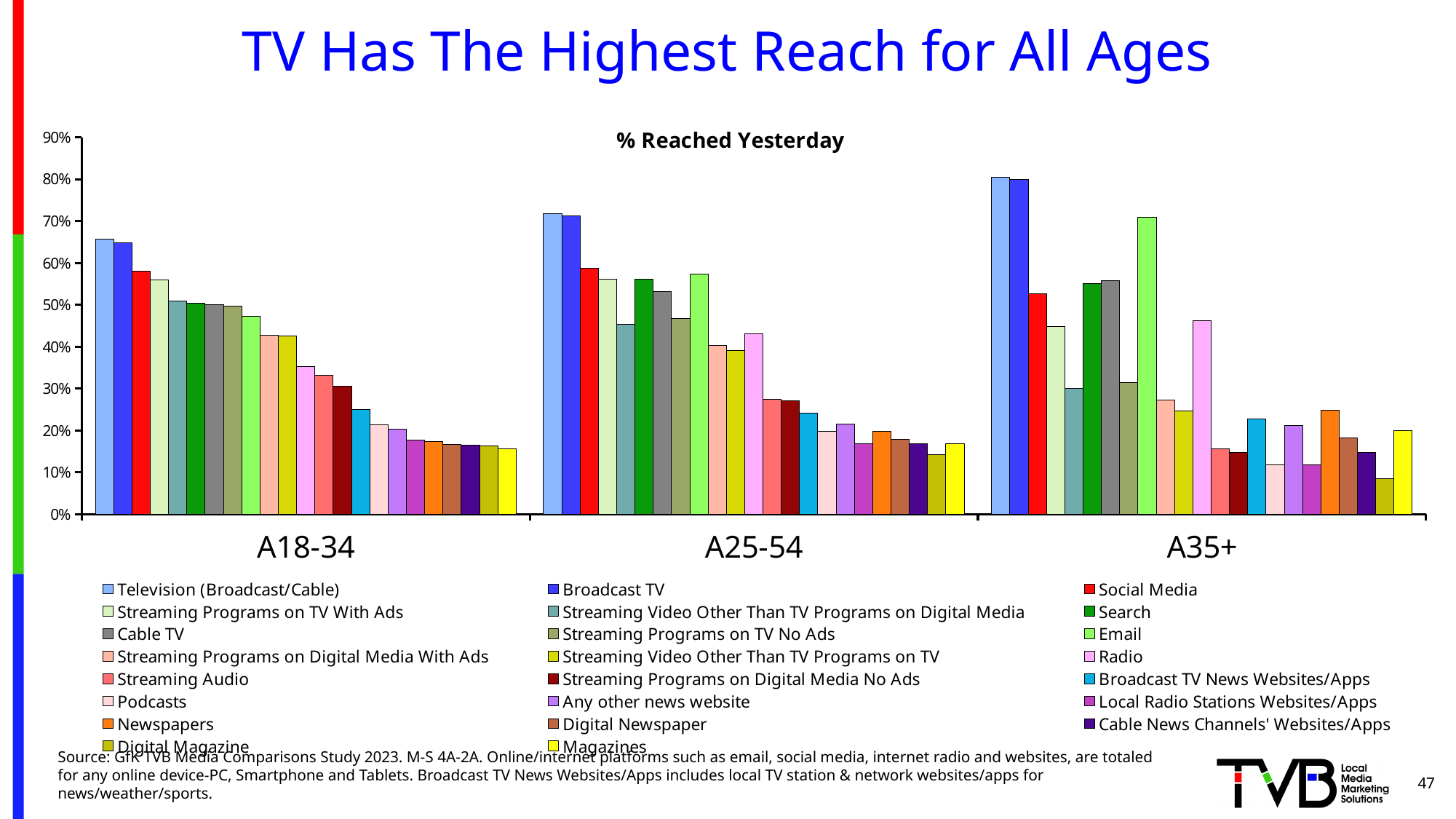
Is the value for Email in the A35+ group greater or less than 60%? greater Does the Email value rise or fall moving from A18-34 to A25-54 to A35+? rise How many series does the legend list? 23 Which age group has the highest Television (Broadcast/Cable) bar? A35+ What kind of chart is shown on the slide? bar chart Which medium has the lowest bar in the A35+ group? Digital Magazine Is the value for Digital Magazine in the A35+ group greater or less than 10%? less How many age groups are shown on the x axis? 3 Which is larger, the Email value for A18-34 or the Email value for A35+? A35+ Is the value for Social Media in the A18-34 group greater or less than 50%? greater What is the title printed above the chart's plot area? % Reached Yesterday